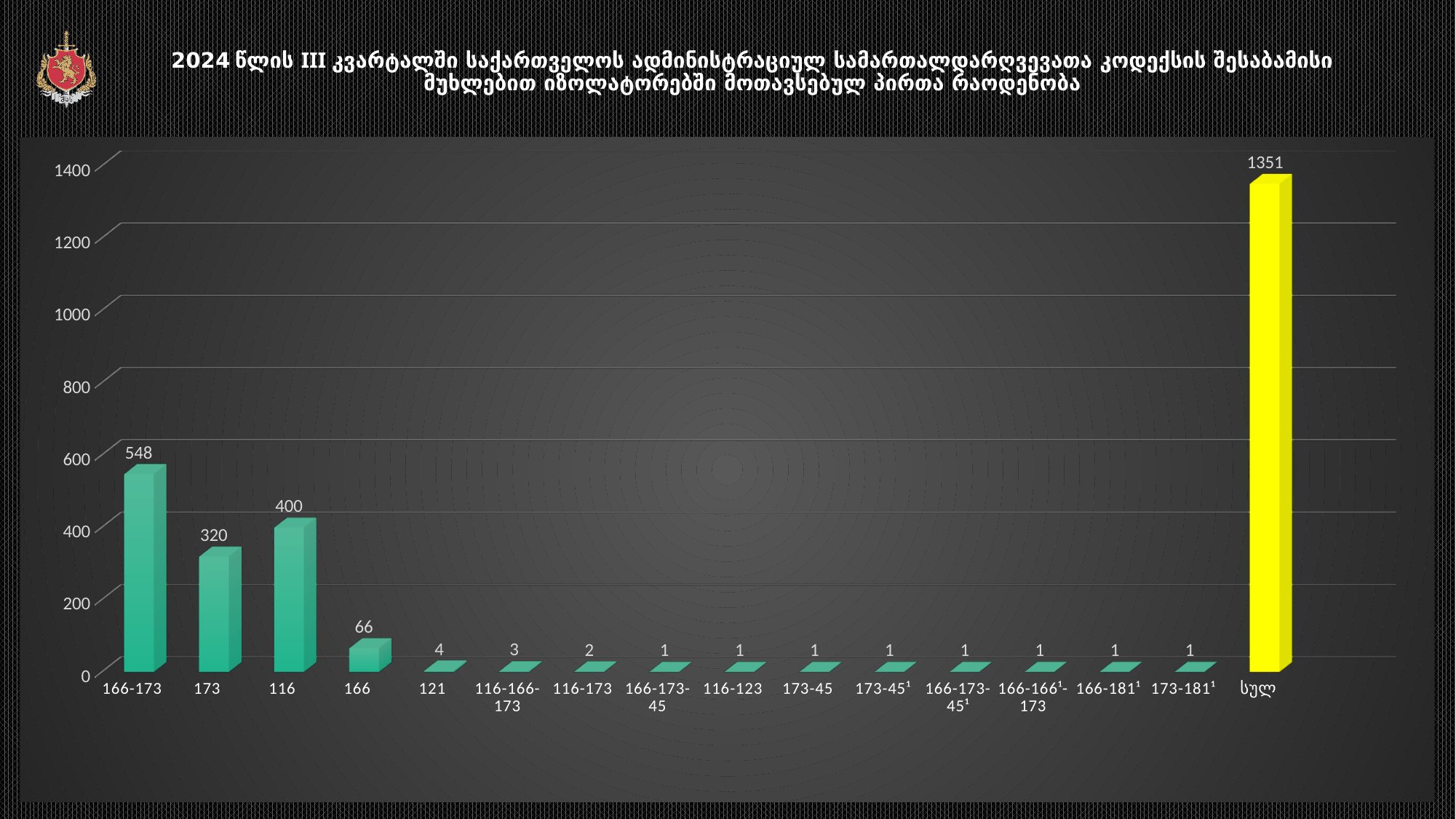
Which is larger, the value for 116 or the value for 173? 116 What is the value for the category 166? 66 What is the value for the category 116? 400 How many categories are shown on the x axis? 16 Excluding the სულ total bar, which category has the highest value? 166-173 What is the value for the category სულ? 1351 What kind of chart is shown on the slide? bar chart What is the value for the category 166-173? 548 Is the value for 166-173 greater or less than 400? greater What colour is the bar for სულ? yellow Which category has the highest value? სულ What is the difference between the values for 166-173 and 173? 228